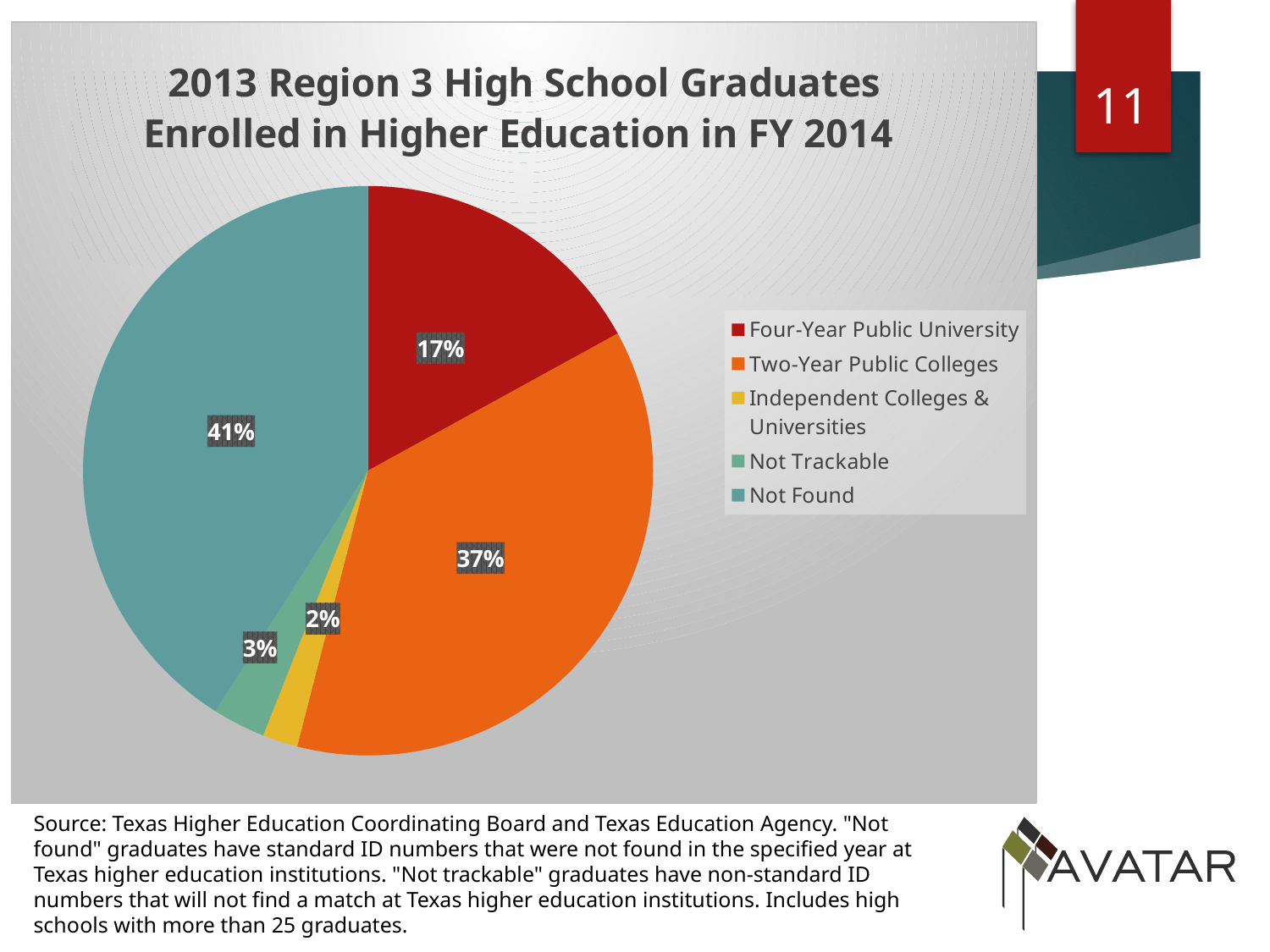
What kind of chart is shown on the slide? Pie chart What is the difference in percentage points between Two-Year Public Colleges and Four-Year Public University? 20 What percentage of graduates is labelled Not Found? 41% What percentage of graduates is labelled Not Trackable? 3% Which category has the smallest share of the pie? Independent Colleges & Universities What percentage of graduates enrolled in a Four-Year Public University? 17% What percentage of graduates enrolled in Independent Colleges & Universities? 2% What percentage of graduates enrolled in Two-Year Public Colleges? 37% How many categories does the legend list? 5 Which is larger, the share for Not Found or the share for Two-Year Public Colleges? Not Found What is the title of the chart? 2013 Region 3 High School Graduates Enrolled in Higher Education in FY 2014 Which category has the largest share of the pie? Not Found